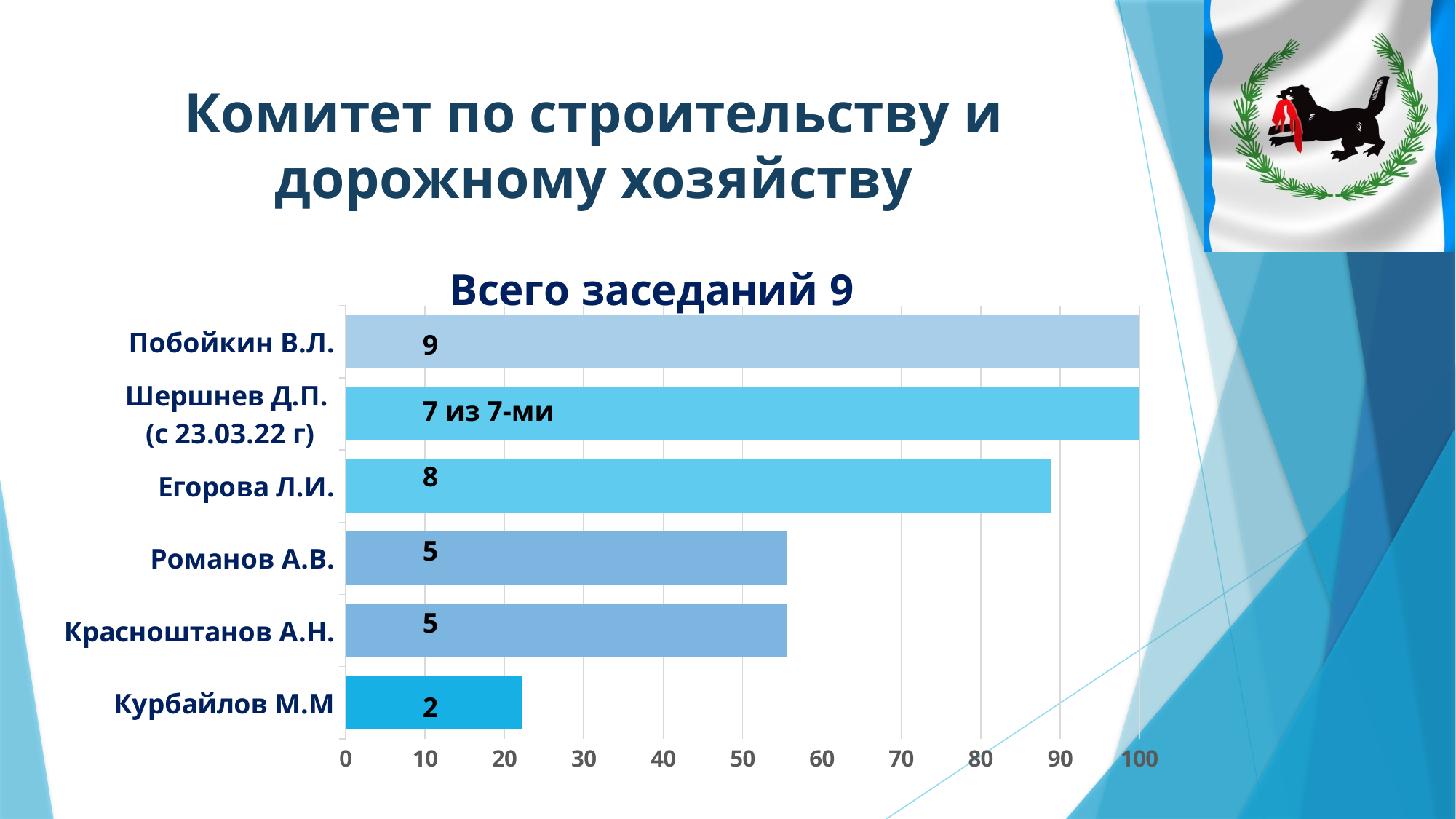
What data label is shown on the bar for Шершнев Д.П. (с 23.03.22 г)? 7 из 7-ми Whose bar is longer, Егорова Л.И. or Красноштанов А.Н.? Егорова Л.И. What data label is shown on the bar for Курбайлов М.М? 2 Is the bar for Егорова Л.И. greater or less than 80 on the axis? greater Is the bar for Курбайлов М.М greater or less than 30 on the axis? less What kind of chart is shown on the slide? bar chart What data label is shown on the bar for Егорова Л.И.? 8 Which category has the shortest bar in the chart? Курбайлов М.М What data label is shown on the bar for Побойкин В.Л.? 9 Is the bar for Романов А.В. greater or less than 60 on the axis? less What is the title of the chart? Всего заседаний 9 How many categories (people) are shown in the chart? 6